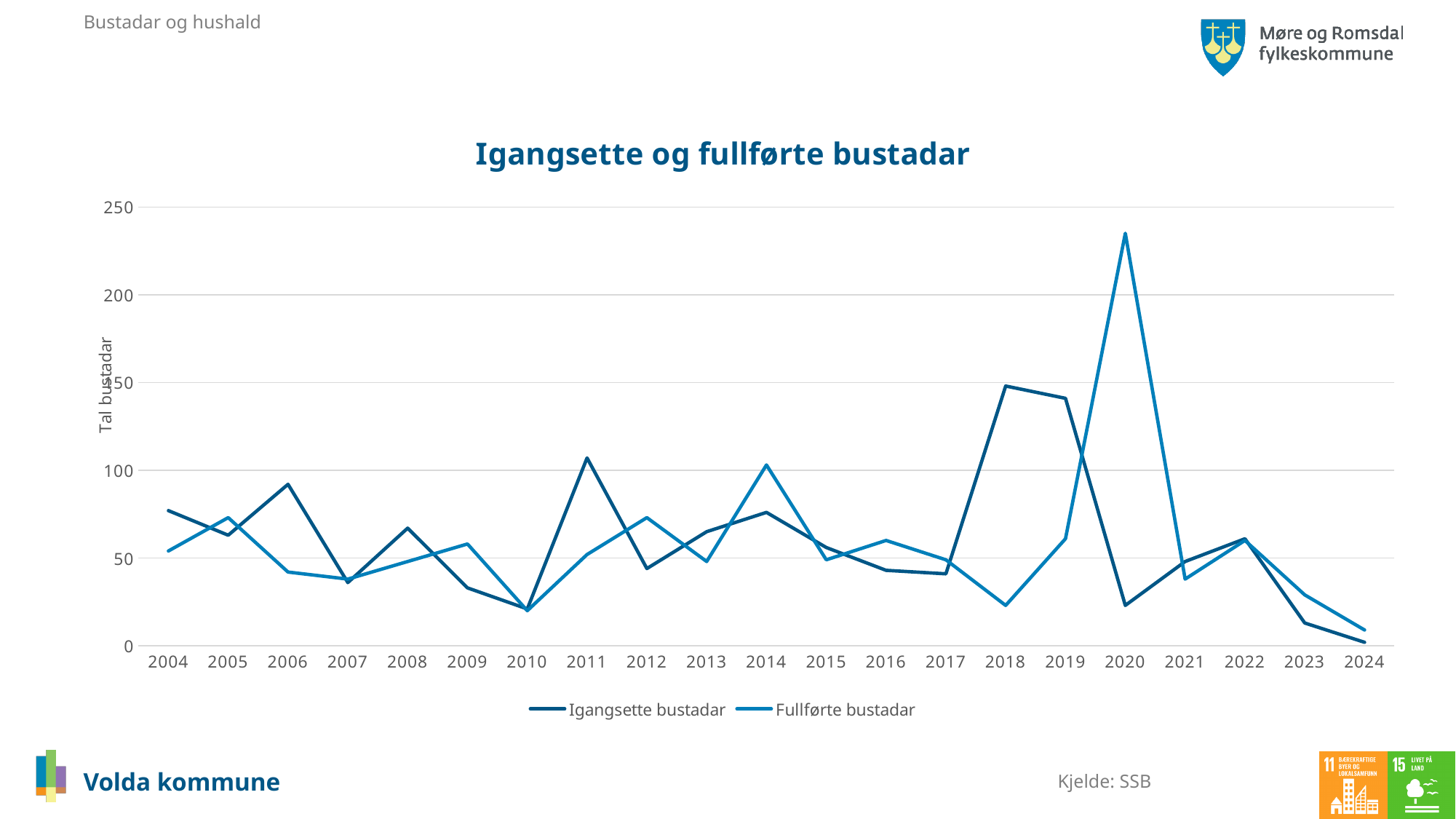
What is the title of the chart? Igangsette og fullførte bustadar In which year does the Fullførte bustadar series reach its highest value? 2020 In which year does the Igangsette bustadar series reach its lowest value? 2024 How many years are shown on the x axis? 21 Is the value for Fullførte bustadar in 2020 greater or less than 200? greater In which year does the Igangsette bustadar series reach its highest value? 2018 Is the value for Igangsette bustadar in 2018 greater or less than 100? greater What kind of chart is shown on the slide? line chart Is the value for Igangsette bustadar in 2010 greater or less than 50? less Do the values for Fullførte bustadar rise or fall from 2020 to 2024? fall How many series does the legend list? 2 In 2018, which series has the larger value, Igangsette bustadar or Fullførte bustadar? Igangsette bustadar